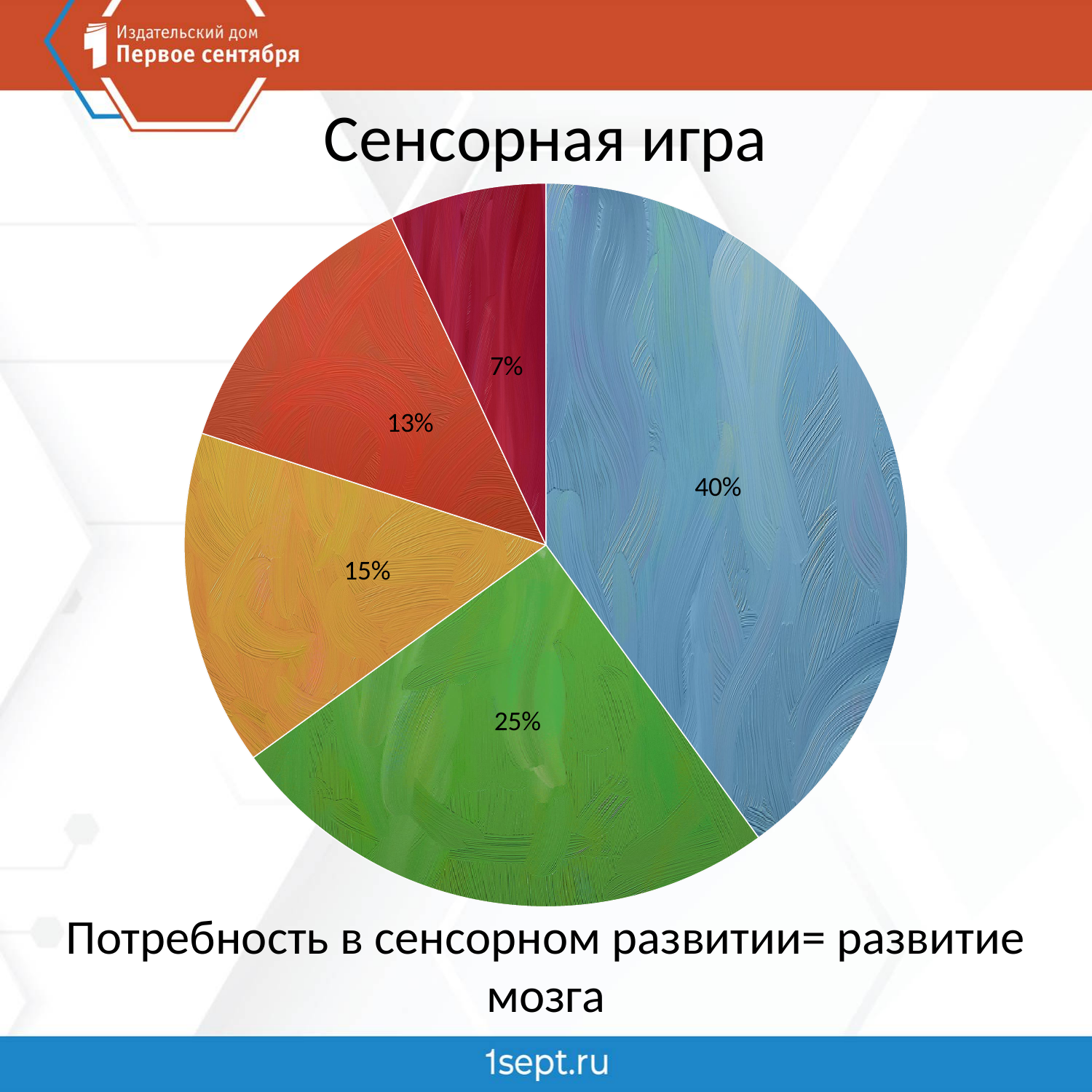
What kind of chart is shown on the slide? pie chart What percentage is shown on the blue slice of the pie chart? 40% What is the largest value shown in the pie chart? 40% What is the smallest value shown in the pie chart? 7% Which slice is larger, the orange-red slice labelled 13% or the yellow-orange slice labelled 15%? the yellow-orange slice (15%) What percentage is shown on the yellow-orange slice of the pie chart? 15% What is the combined share of the two smallest slices (13% and 7%)? 20% What is the difference between the blue slice (40%) and the green slice (25%)? 15% What percentage is shown on the green slice of the pie chart? 25% How many slices does the pie chart have? 5 What percentage is shown on the dark red slice of the pie chart? 7% What is the title shown above the pie chart? Сенсорная игра